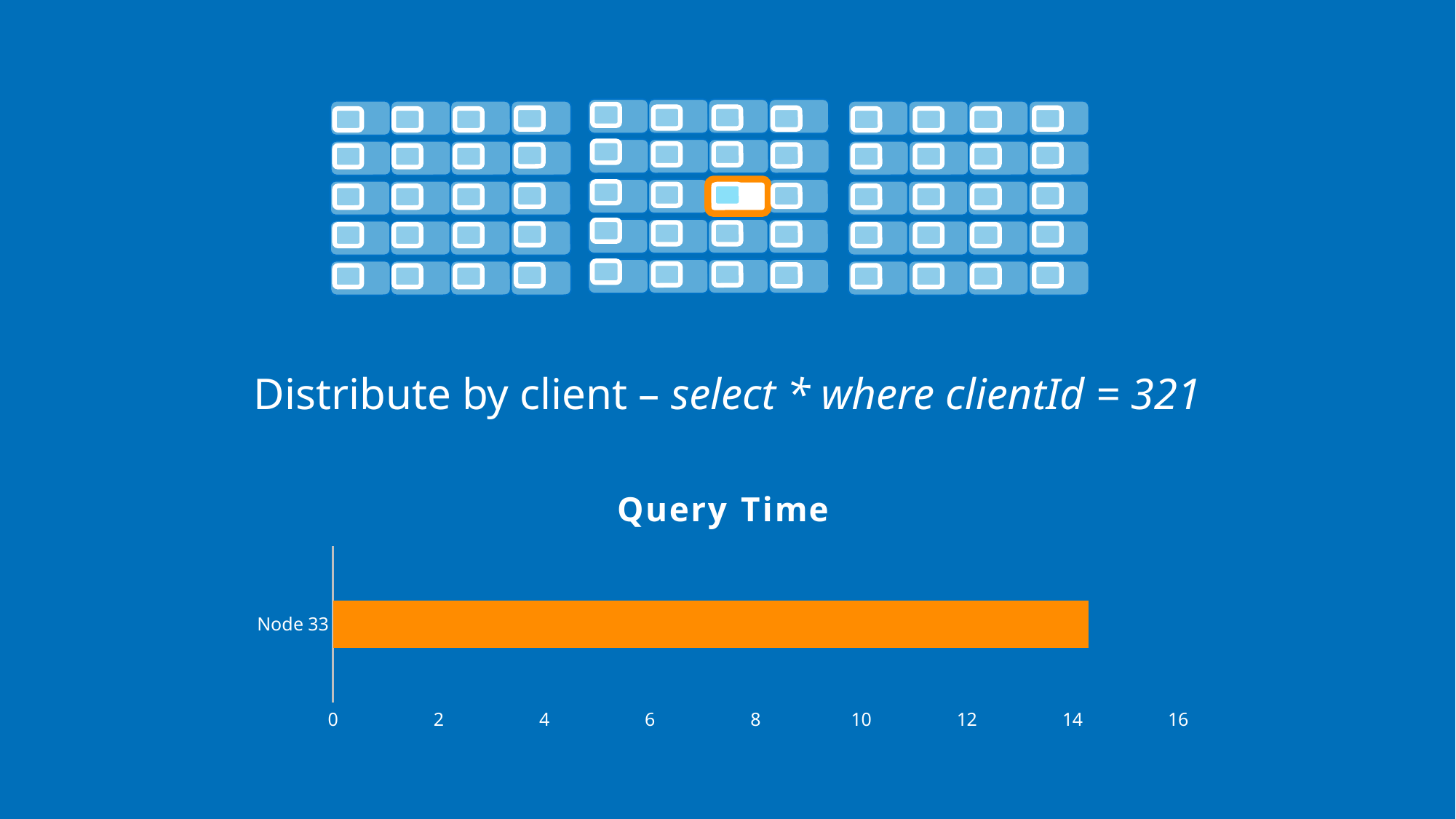
Which category is plotted in the Query Time chart? Node 33 In the Query Time chart, is the value for Node 33 greater or less than 8? greater How many categories are plotted in the Query Time chart? 1 In the Query Time chart, is the value for Node 33 greater or less than 10? greater In the Query Time chart, is the value for Node 33 greater or less than 16? less What is the title of the chart on the slide? Query Time What kind of chart is shown under the title "Query Time"? bar chart What is the highest tick value shown on the x axis of the Query Time chart? 16